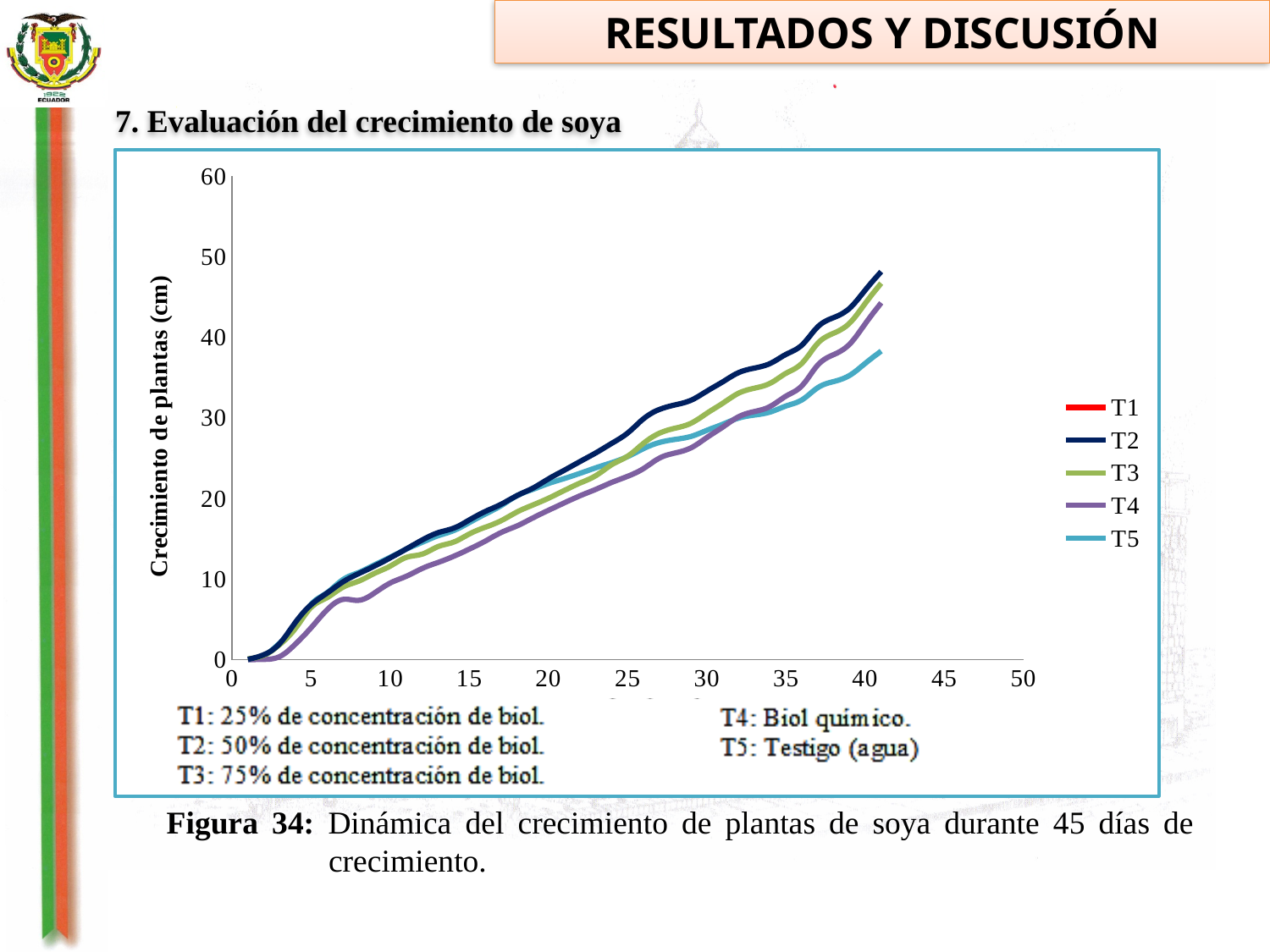
Is the value for T2 at x = 5 greater or less than 10? less What is the maximum value shown on the y axis? 60 At x = 15, which line is higher, T3 or T4? T3 Do the plotted lines rise or fall as the x axis increases? rise Which visible line is the lowest at x = 40? T5 Is the value for T5 at x = 40 greater or less than 40? less What is the label of the y axis? Crecimiento de plantas (cm) At x = 40, which line is higher, T2 or T5? T2 What kind of chart is shown on the slide? line chart Is the value for T4 at x = 25 greater or less than 30? less How many series does the legend list? 5